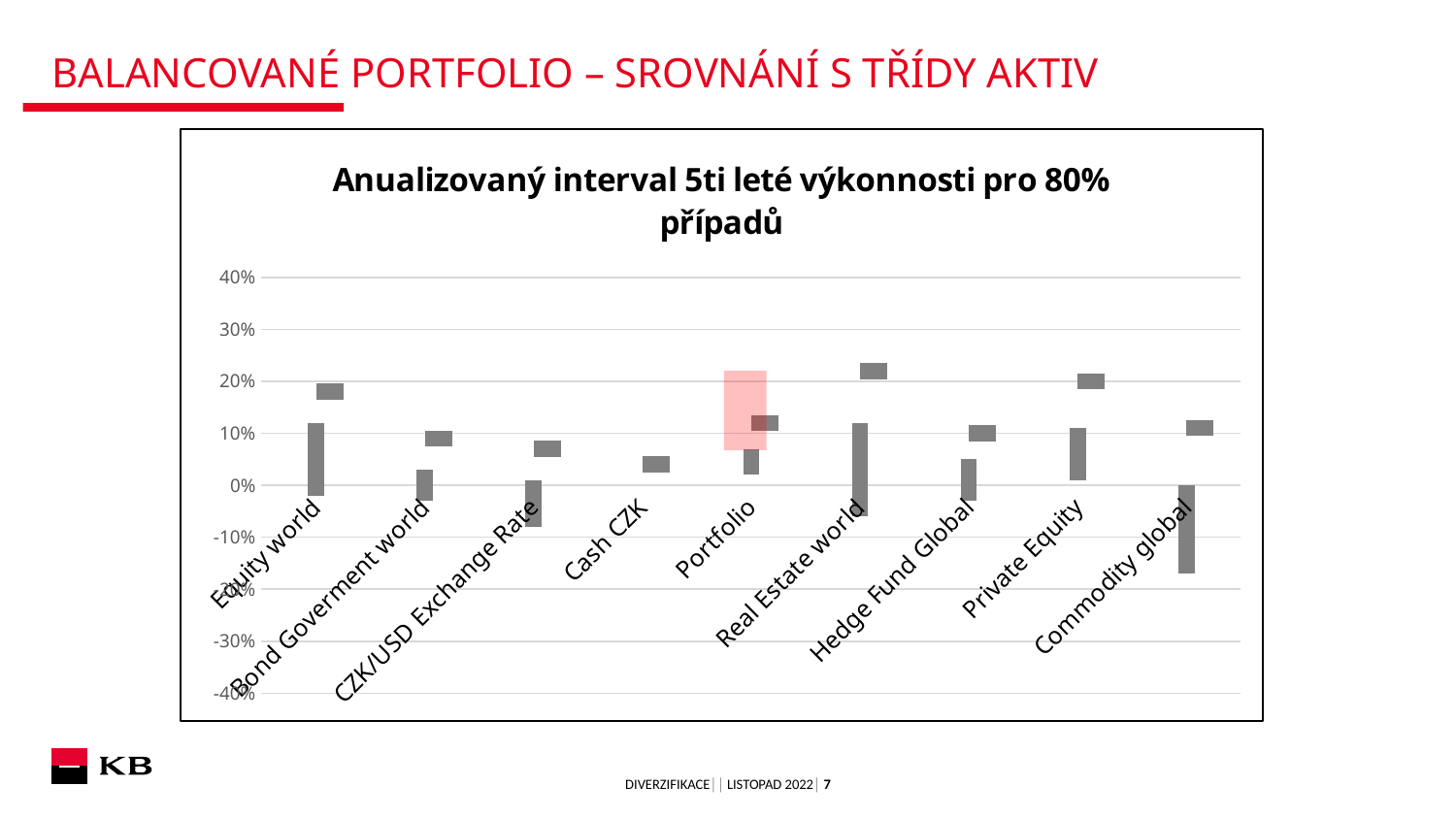
Is the upper marker for Equity world greater or less than 10%? greater What is the title of the chart? Anualizovaný interval 5ti leté výkonnosti pro 80% případů Is the upper marker for Real Estate world greater or less than 20%? greater How many asset classes (categories) are shown on the x axis of the chart? 9 Is the lower end of the bar for Private Equity greater or less than 0%? greater Which category is highlighted with a pink shaded box in the chart? Portfolio Which has a lower bottom end of its bar: Commodity global or Cash CZK? Commodity global Which category's bar extends lowest below 0% in the chart? Commodity global What is the highest value shown on the y axis of the chart? 40% What kind of chart is shown on the slide? bar chart